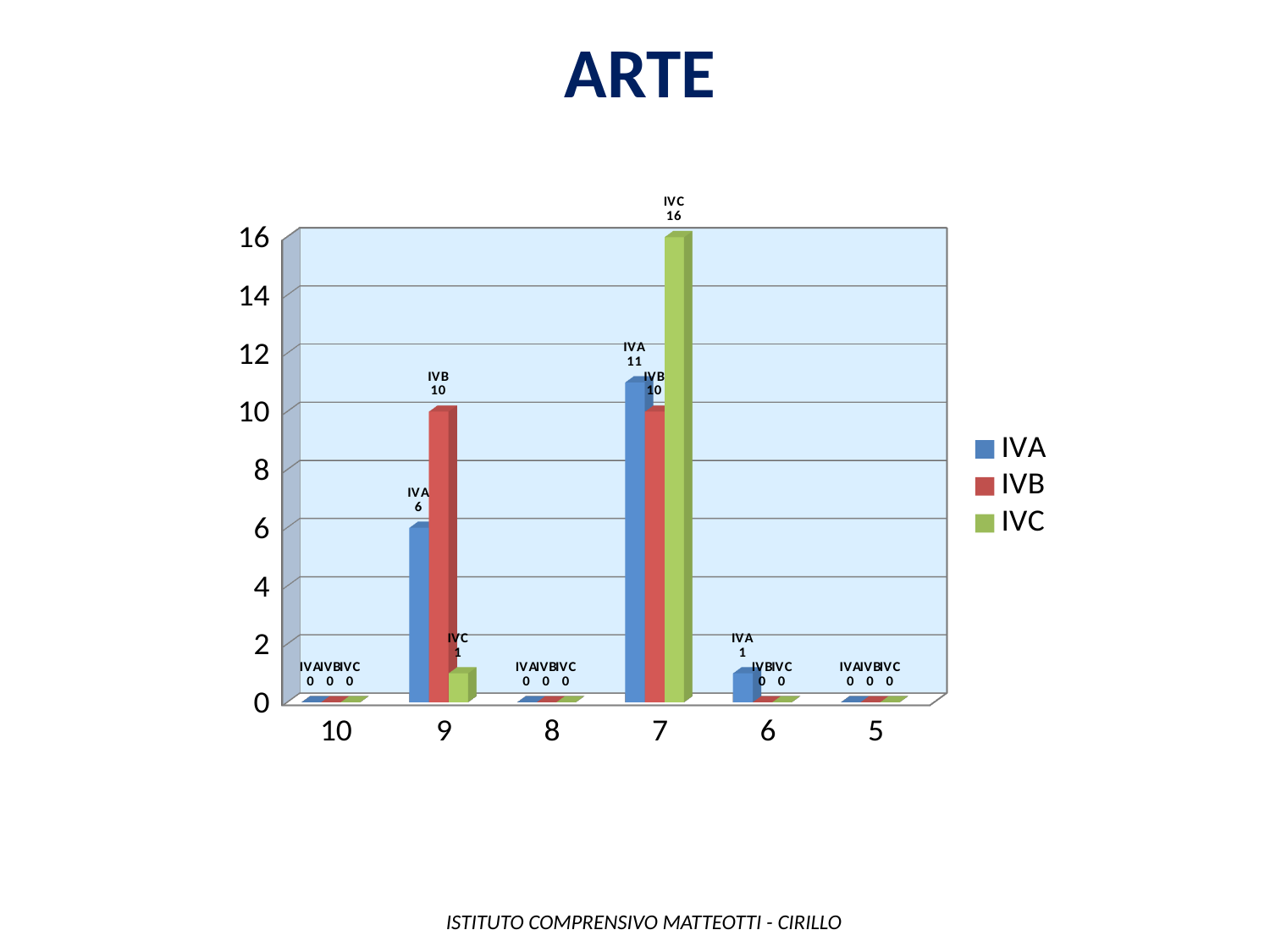
Which category has the highest value for the IVC series? 7 At category 9, which series has the larger value, IVA or IVB? IVB How many series does the legend list? 3 What is the difference between the IVB and IVA values at category 9? 4 What is the value for IVC at category 7? 16 What is the value for IVB at category 9? 10 What kind of chart is shown on the slide? bar chart What is the value for IVA at category 6? 1 What is the difference between the IVC and IVA values at category 7? 5 What is the title of the chart? ARTE What is the value for IVC at category 9? 1 How many categories are shown on the x axis? 6